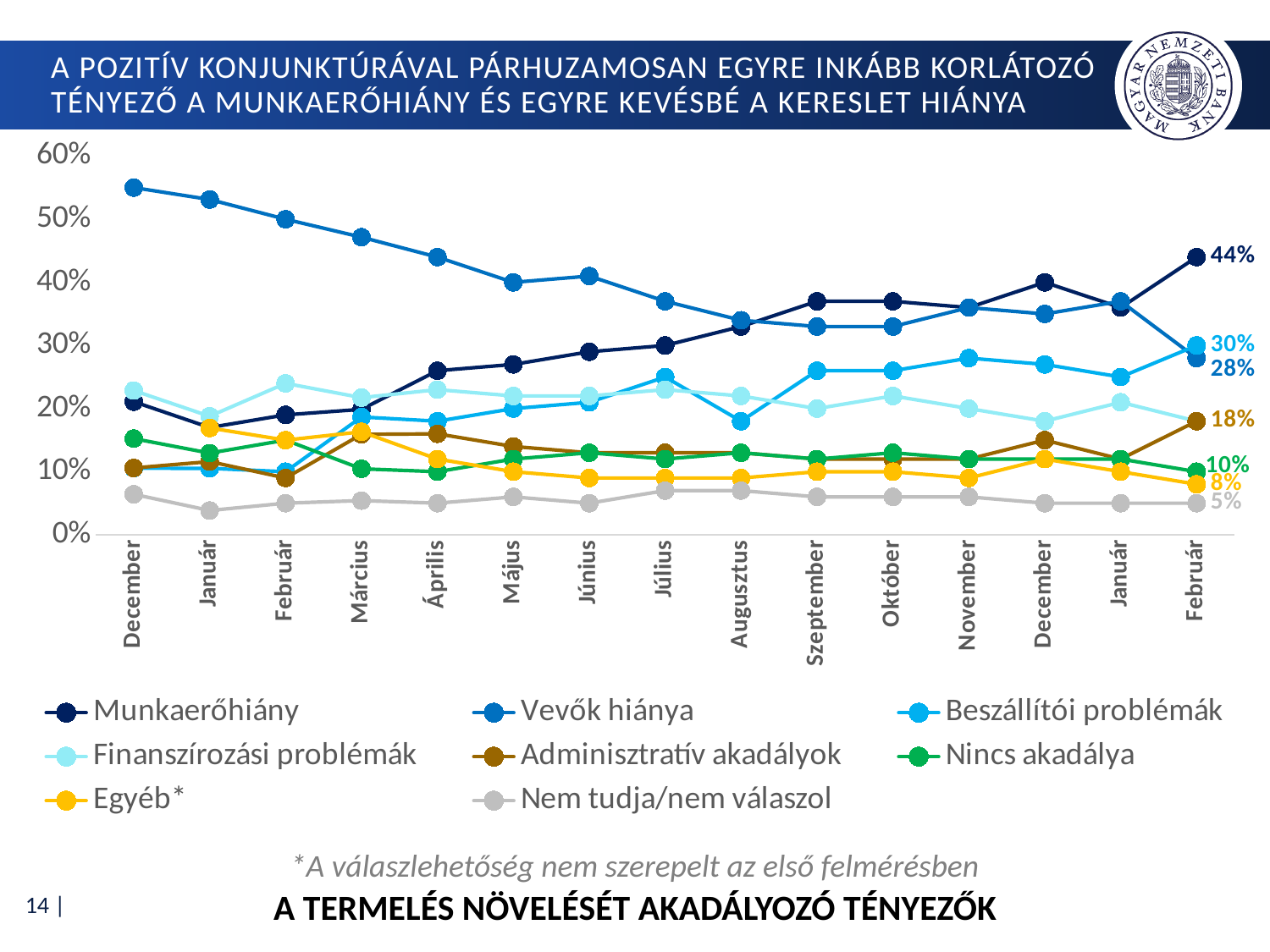
What is the value for Vevők hiánya in the final Február? 28% How many series does the legend list? 8 What is the value for Beszállítói problémák in the final Február? 30% Which series has the highest value in the final Február? Munkaerőhiány Is the value for Vevők hiánya in the first December greater or less than 50%? greater How many months are shown along the x axis? 15 What is the value for Munkaerőhiány in the final Február? 44% What type of chart is shown on the slide? line chart Does the Vevők hiánya series rise or fall from the first December to the final Február? fall What is the value for Nem tudja/nem válaszol in the final Február? 5% What is the difference between Munkaerőhiány and Vevők hiánya in the final Február? 16 percentage points In the final Február, which is larger: Nincs akadálya or Egyéb*? Nincs akadálya